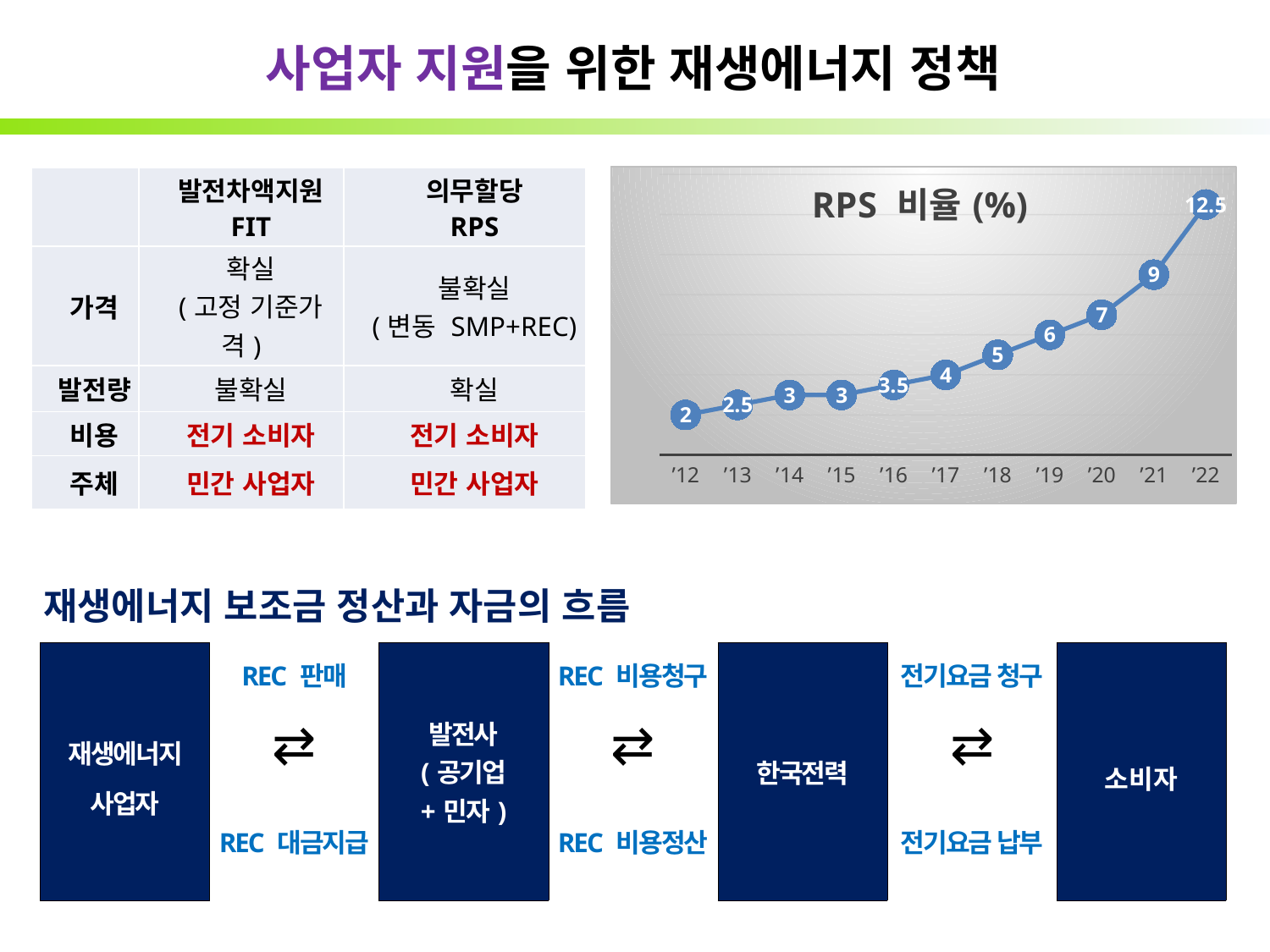
In the RPS 비율 (%) chart, do the values rise or fall from '12 to '22? rise In the RPS 비율 (%) chart, what is the value for '22? 12.5 In the RPS 비율 (%) chart, what is the value for '21? 9 In the RPS 비율 (%) chart, which year has the highest value? '22 In the RPS 비율 (%) chart, which year has the lowest value? '12 What is the title of the chart on the slide? RPS 비율 (%) How many data points are plotted in the RPS 비율 (%) chart? 11 What kind of chart is the RPS 비율 (%) chart? line chart In the RPS 비율 (%) chart, what is the value for '12? 2 In the RPS 비율 (%) chart, what is the value for '16? 3.5 In the RPS 비율 (%) chart, what is the difference between the values for '22 and '21? 3.5 In the RPS 비율 (%) chart, which is larger, the value for '18 or the value for '17? '18